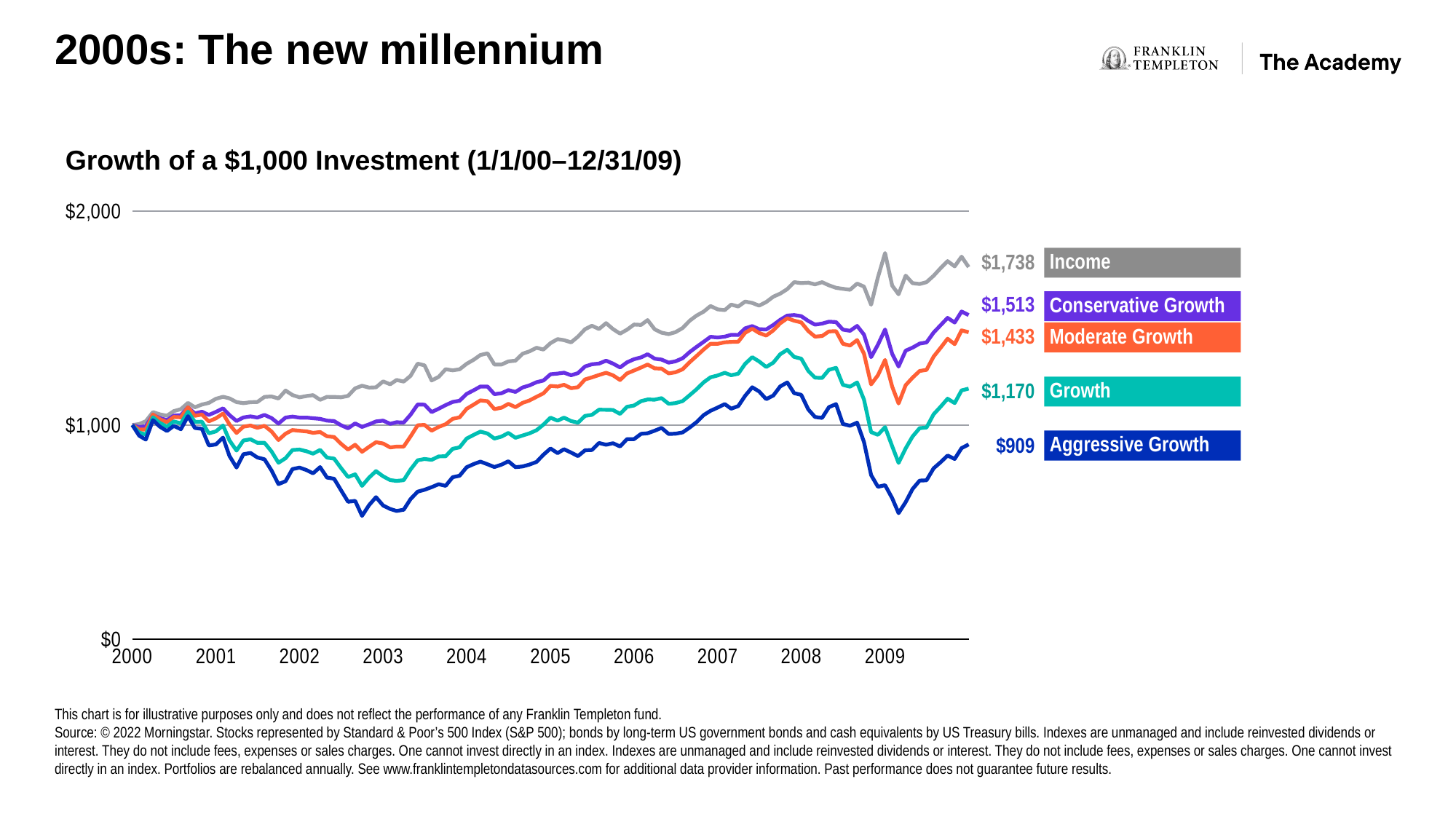
Which portfolio has the lowest ending value? Aggressive Growth What is the ending value of the Moderate Growth portfolio? $1,433 Which has a higher ending value, Growth or Conservative Growth? Conservative Growth What is the difference between the ending values of Income and Aggressive Growth? $829 Is the ending value of the Aggressive Growth portfolio greater or less than $1,000? less What is the ending value of the Aggressive Growth portfolio? $909 How many portfolios are plotted on the chart? 5 Which portfolio has the highest ending value? Income What is the ending value of the Income portfolio? $1,738 What is the title of the chart? Growth of a $1,000 Investment (1/1/00–12/31/09) What type of chart is shown? Line chart What is the difference between the ending values of Conservative Growth and Moderate Growth? $80